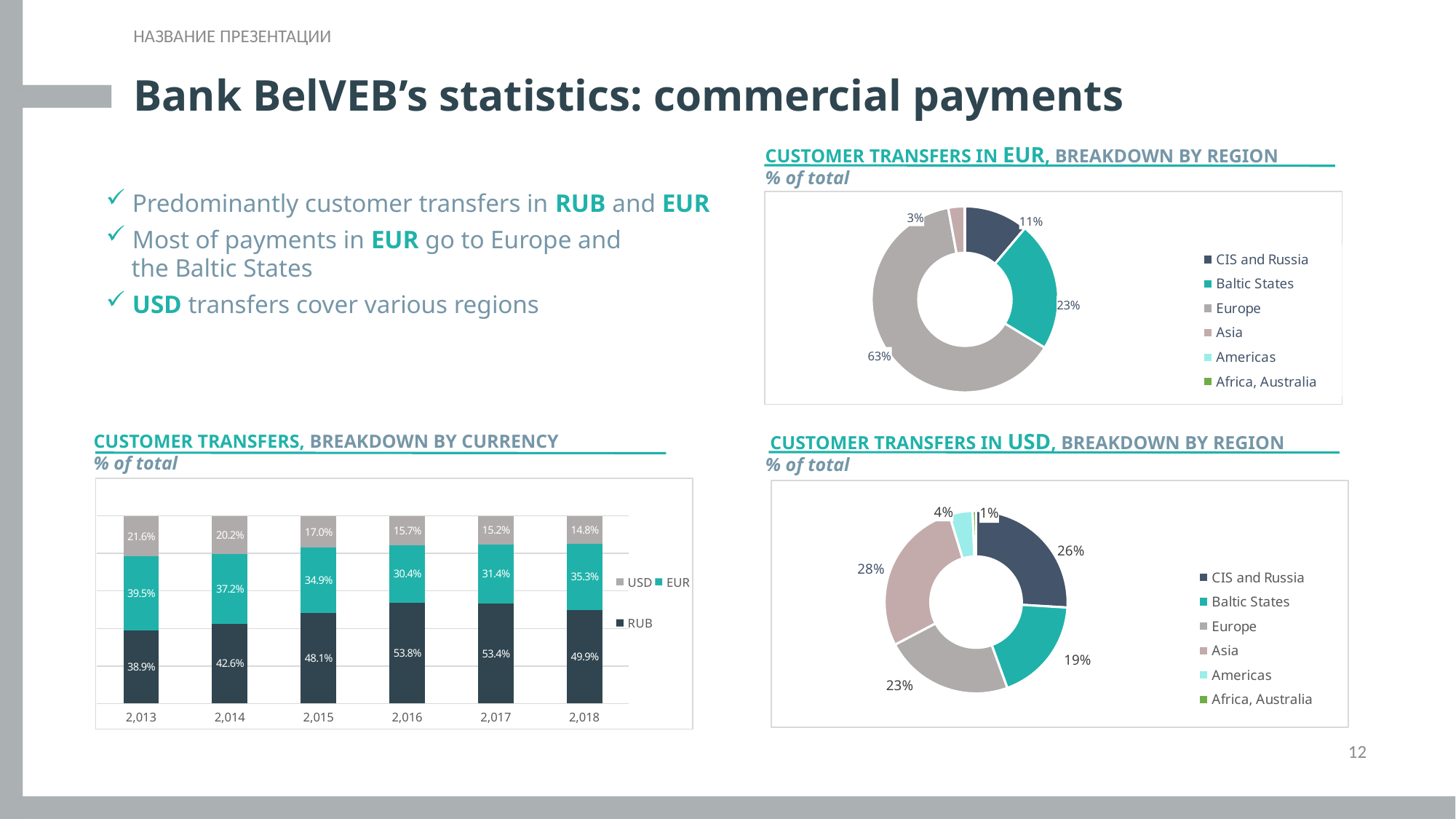
In the 'Customer transfers, breakdown by currency' chart, how much higher is the RUB share in 2,018 than in 2,013? 11.0 percentage points In the 'Customer transfers in EUR, breakdown by region' chart, what share goes to Europe? 63% In the 'Customer transfers in EUR, breakdown by region' chart, which region has the largest share? Europe In the 'Customer transfers, breakdown by currency' chart, which year has the lowest USD share? 2,018 In the 'Customer transfers, breakdown by currency' chart, what is the RUB share in 2,016? 53.8% In the 'Customer transfers, breakdown by currency' chart, does the USD share rise or fall from 2,013 to 2,018? fall In the 'Customer transfers in USD, breakdown by region' chart, what share goes to Asia? 28% In the 'Customer transfers, breakdown by currency' chart, how many years are shown on the x axis? 6 In the 'Customer transfers in USD, breakdown by region' chart, which is larger: the share for CIS and Russia or the share for Baltic States? CIS and Russia In the 'Customer transfers, breakdown by currency' chart, what is the USD share in 2,013? 21.6% What kind of chart is 'Customer transfers, breakdown by currency'? stacked bar chart In the 'Customer transfers, breakdown by currency' chart, how many series does the legend list? 3